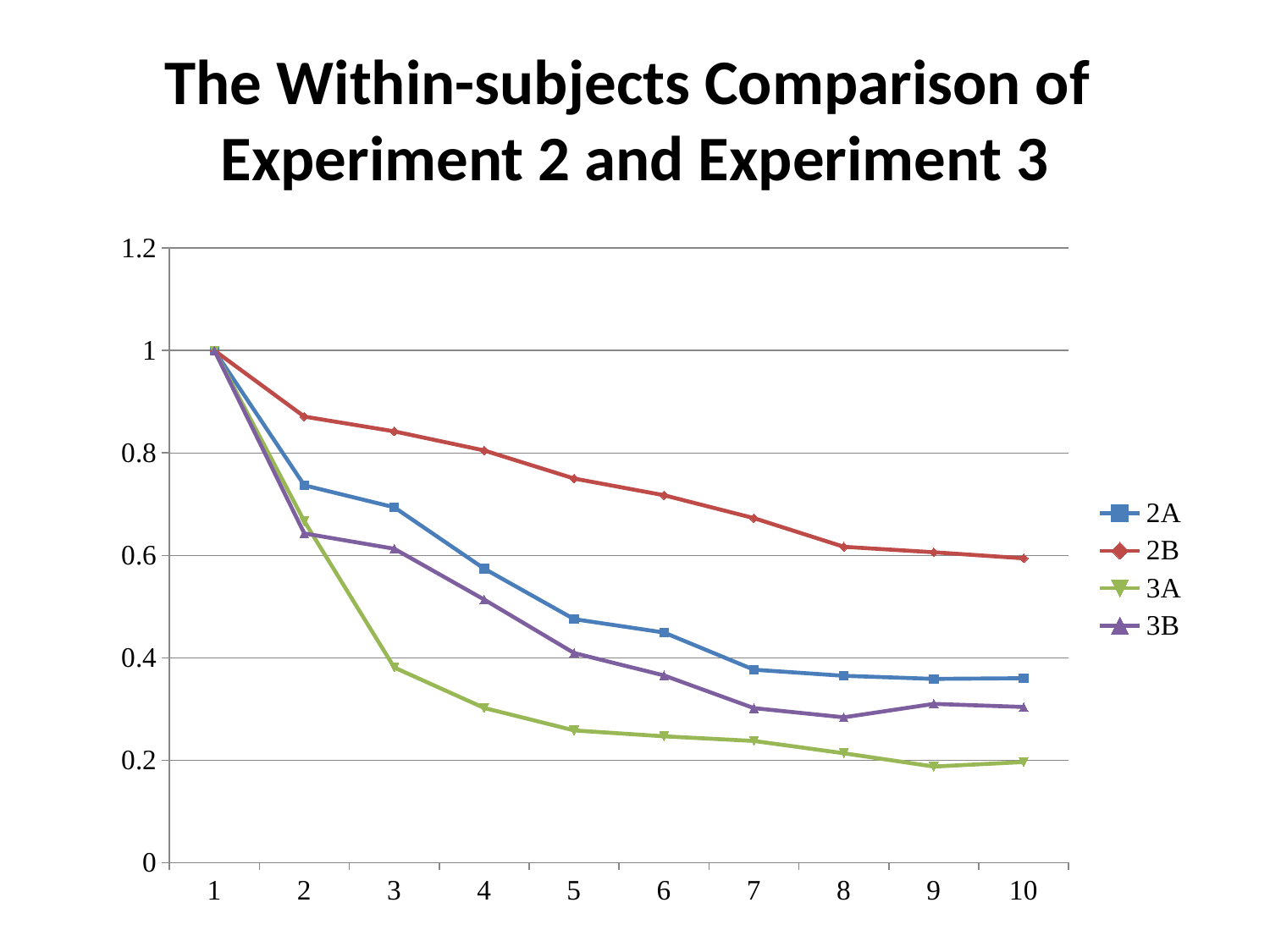
Is the value of series 2B at x = 5 greater or less than 0.6? greater How many series does the legend list? 4 Is the value of series 3A at x = 9 greater or less than 0.2? less Which series has the highest value at x = 10? 2B How many points along the x axis does each series have? 10 Do the values of series 2B rise or fall as x increases from 1 to 10? fall What is the title of the chart? The Within-subjects Comparison of Experiment 2 and Experiment 3 At x = 3, which series has the larger value, 2A or 3B? 2A Which series has the lowest value at x = 10? 3A Is the value of series 2A at x = 4 greater or less than 0.6? less What kind of chart is shown on the slide? line chart What is the value of series 2B at x = 1? 1